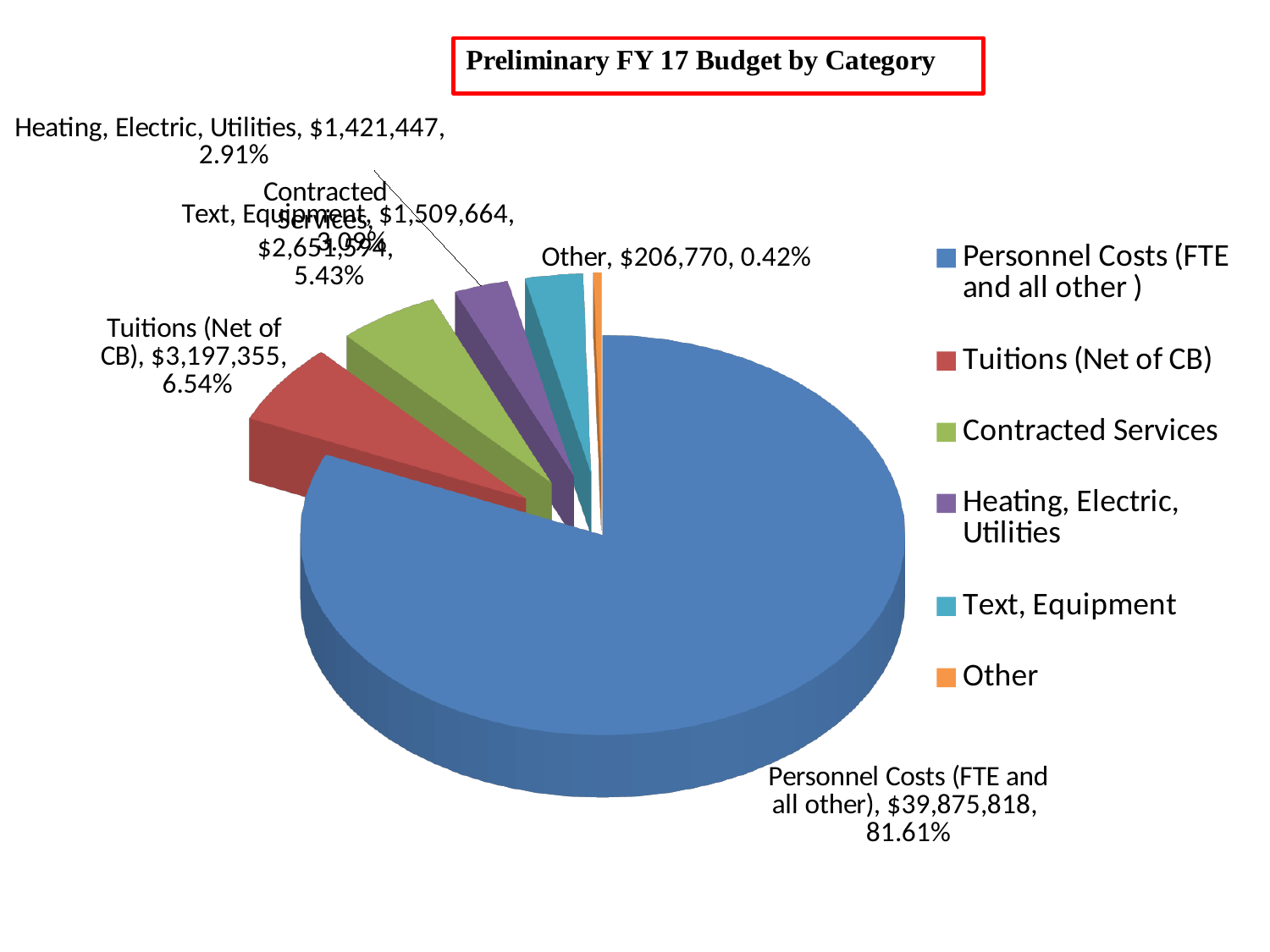
What is the value for Personnel Costs (FTE and all other)? $39,875,818 What is the value for Other? $206,770 What is the value for Tuitions (Net of CB)? $3,197,355 How many categories does the legend list? 6 What share of the pie is Tuitions (Net of CB)? 6.54% What is the title of the chart? Preliminary FY 17 Budget by Category What share of the pie is Personnel Costs (FTE and all other)? 81.61% Which category has the largest slice? Personnel Costs (FTE and all other) What is the value for Heating, Electric, Utilities? $1,421,447 Which is larger, Tuitions (Net of CB) or Heating, Electric, Utilities? Tuitions (Net of CB) Which category has the smallest slice? Other What kind of chart is shown on the slide? Pie chart